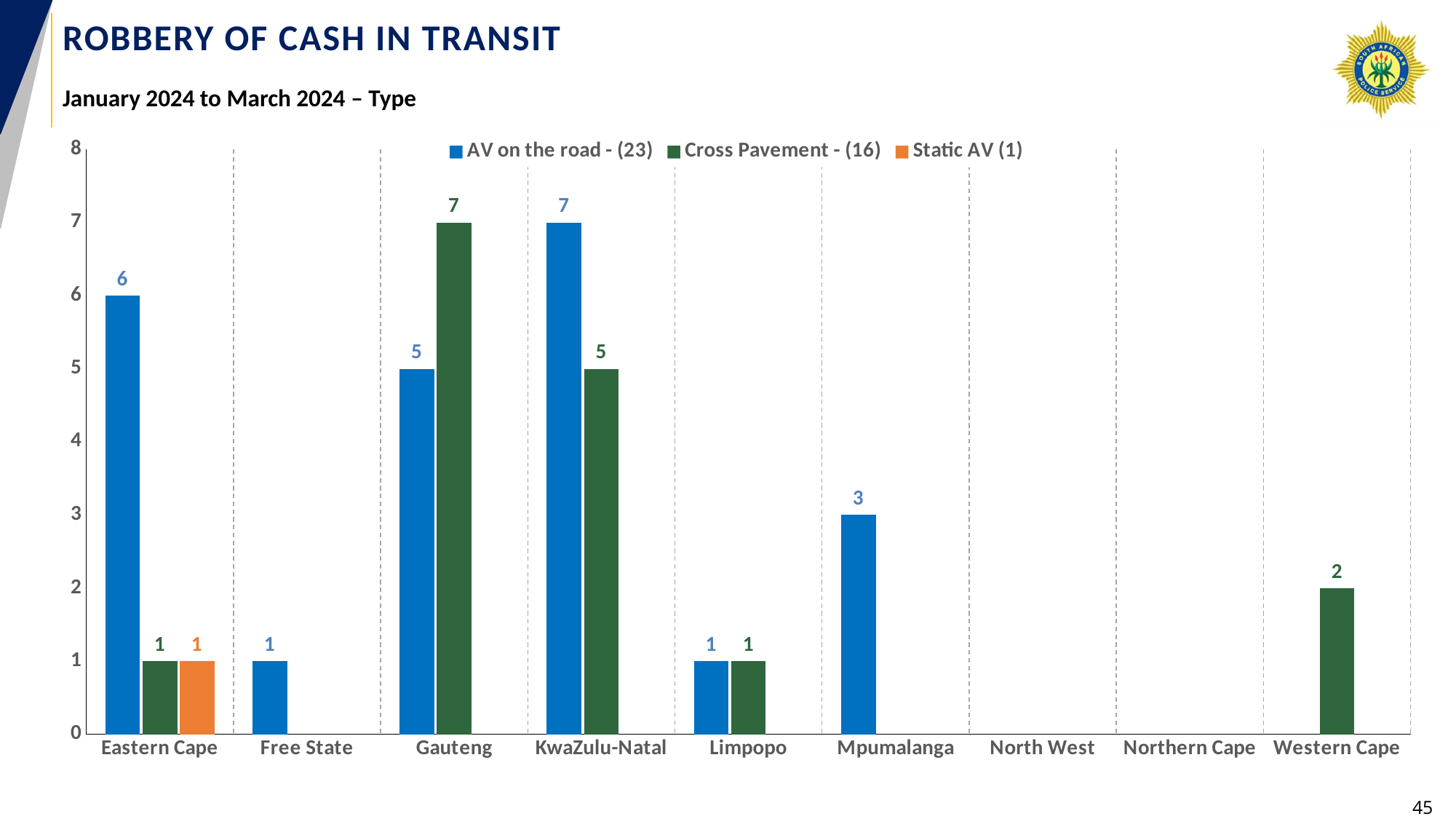
What is the difference between the AV on the road value and the Cross Pavement value in KwaZulu-Natal? 2 What is the value for AV on the road in Mpumalanga? 3 What is the value for Cross Pavement in Gauteng? 7 What kind of chart is shown on the slide? Bar chart How many series does the legend list? 3 Which is larger in Gauteng: AV on the road or Cross Pavement? Cross Pavement Which province is the only one with a Static AV value? Eastern Cape What is the value for AV on the road in Eastern Cape? 6 What is the value for Cross Pavement in Western Cape? 2 Which province has the highest value for Cross Pavement? Gauteng How many provinces are shown on the x axis? 9 Which province has the highest value for AV on the road? KwaZulu-Natal